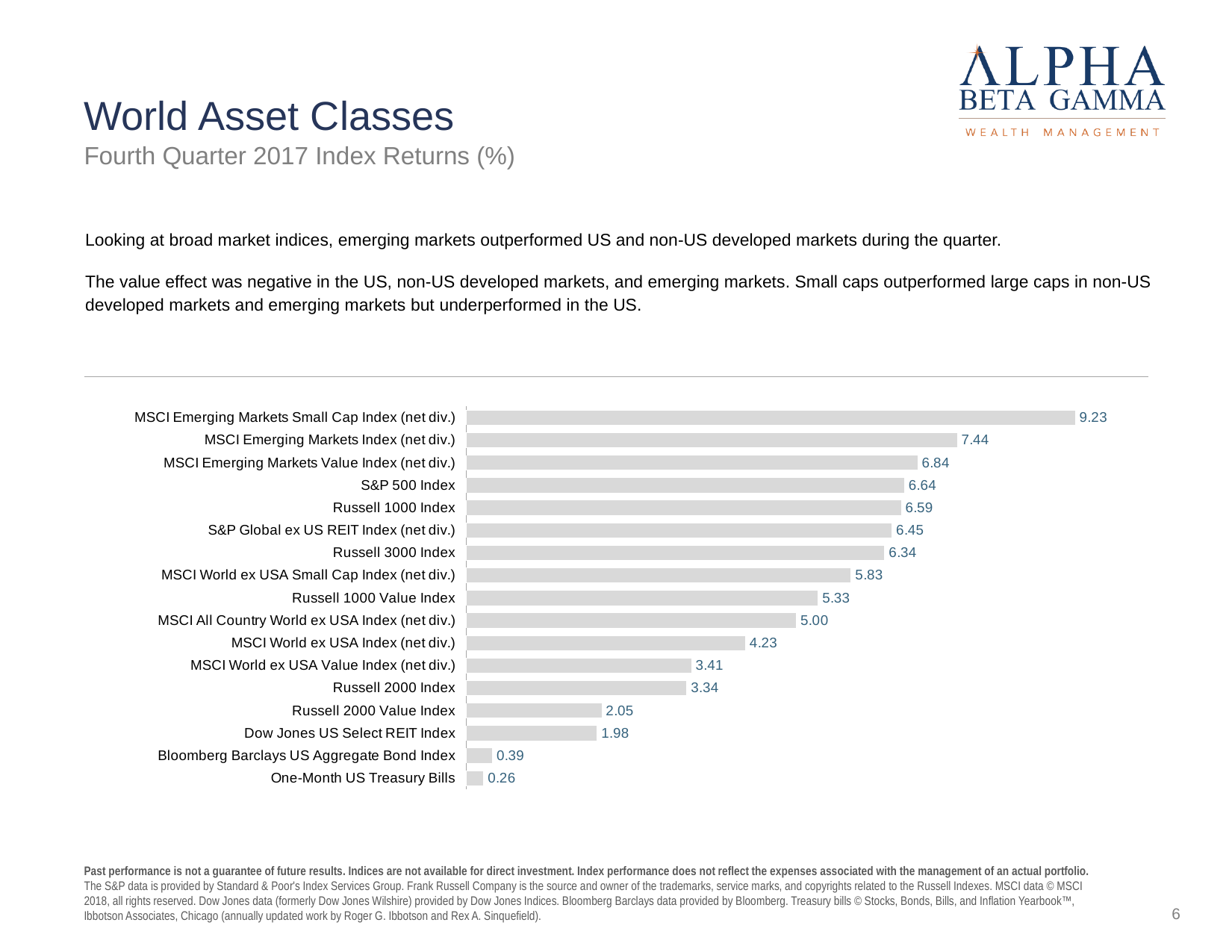
What kind of chart is shown on the slide? Bar chart How many indices are shown on the chart? 17 What is the subtitle of the slide describing the chart's data? Fourth Quarter 2017 Index Returns (%) What is the difference between the MSCI Emerging Markets Small Cap Index (net div.) and the MSCI Emerging Markets Index (net div.)? 1.79 Which index has the lowest value on the chart? One-Month US Treasury Bills What is the difference between the Russell 2000 Index and the Russell 2000 Value Index? 1.29 What is the value for the MSCI World ex USA Index (net div.)? 4.23 Which is larger, the Dow Jones US Select REIT Index or the S&P Global ex US REIT Index (net div.)? S&P Global ex US REIT Index (net div.) Which is larger, the Russell 1000 Index or the Russell 2000 Index? Russell 1000 Index What is the value for the Russell 2000 Value Index? 2.05 What is the value for the S&P 500 Index? 6.64 Which index has the highest value on the chart? MSCI Emerging Markets Small Cap Index (net div.)